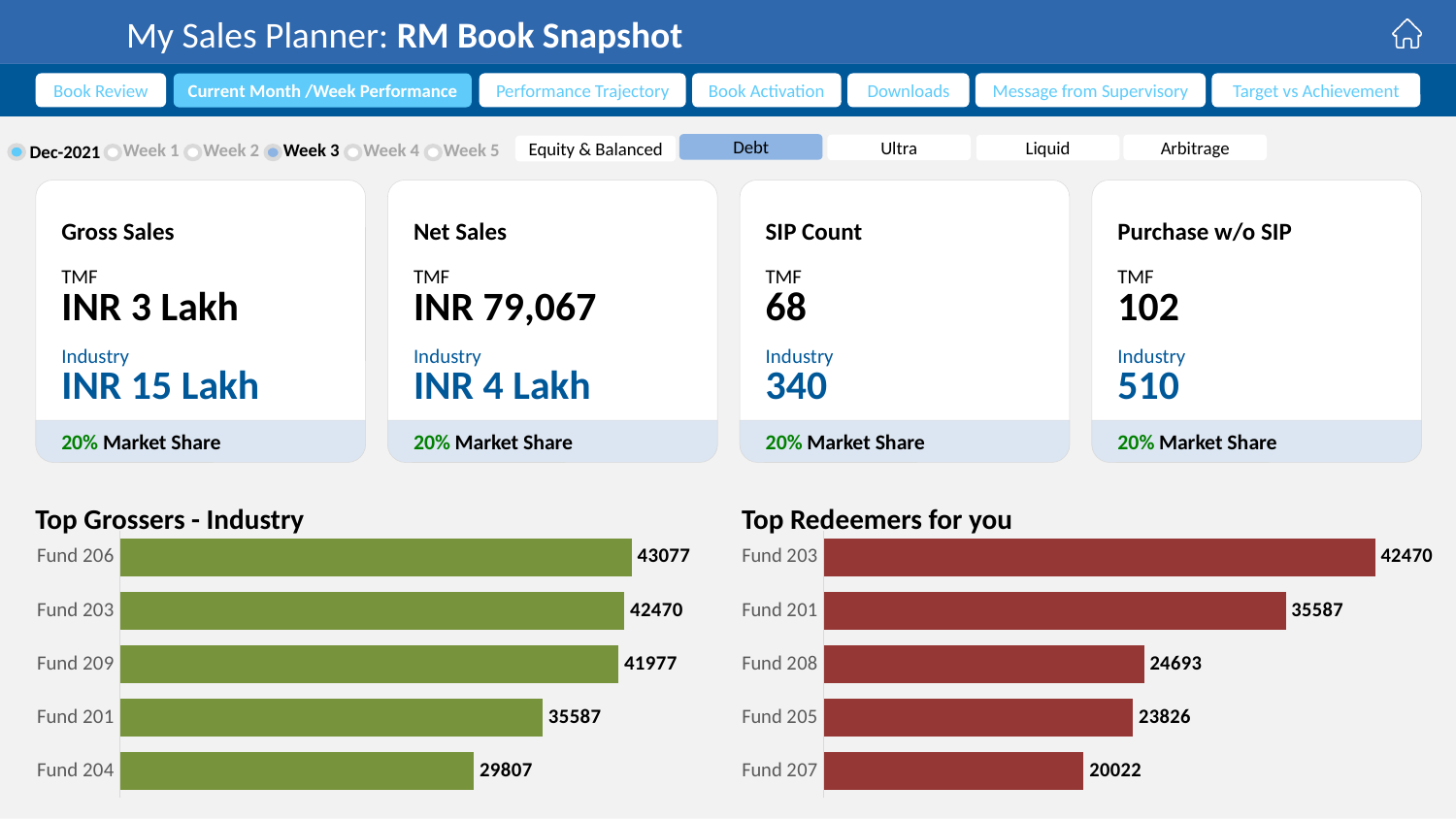
In the Top Redeemers for you chart, what is the value for Fund 208? 24693 What kind of chart is the Top Redeemers for you chart? Bar chart In the Top Grossers - Industry chart, what is the value for Fund 209? 41977 In the Top Grossers - Industry chart, which fund has the highest value? Fund 206 In the Top Redeemers for you chart, which fund has the lowest value? Fund 207 In the Top Redeemers for you chart, what is the difference between the values for Fund 201 and Fund 205? 11761 In the Top Redeemers for you chart, which fund has the highest value? Fund 203 In the Top Grossers - Industry chart, what is the difference between the values for Fund 206 and Fund 204? 13270 In the Top Redeemers for you chart, which is larger, the value for Fund 208 or Fund 205? Fund 208 What colour are the bars in the Top Grossers - Industry chart? Green In the Top Grossers - Industry chart, how many funds are shown? 5 In the Top Grossers - Industry chart, which fund has the lowest value? Fund 204